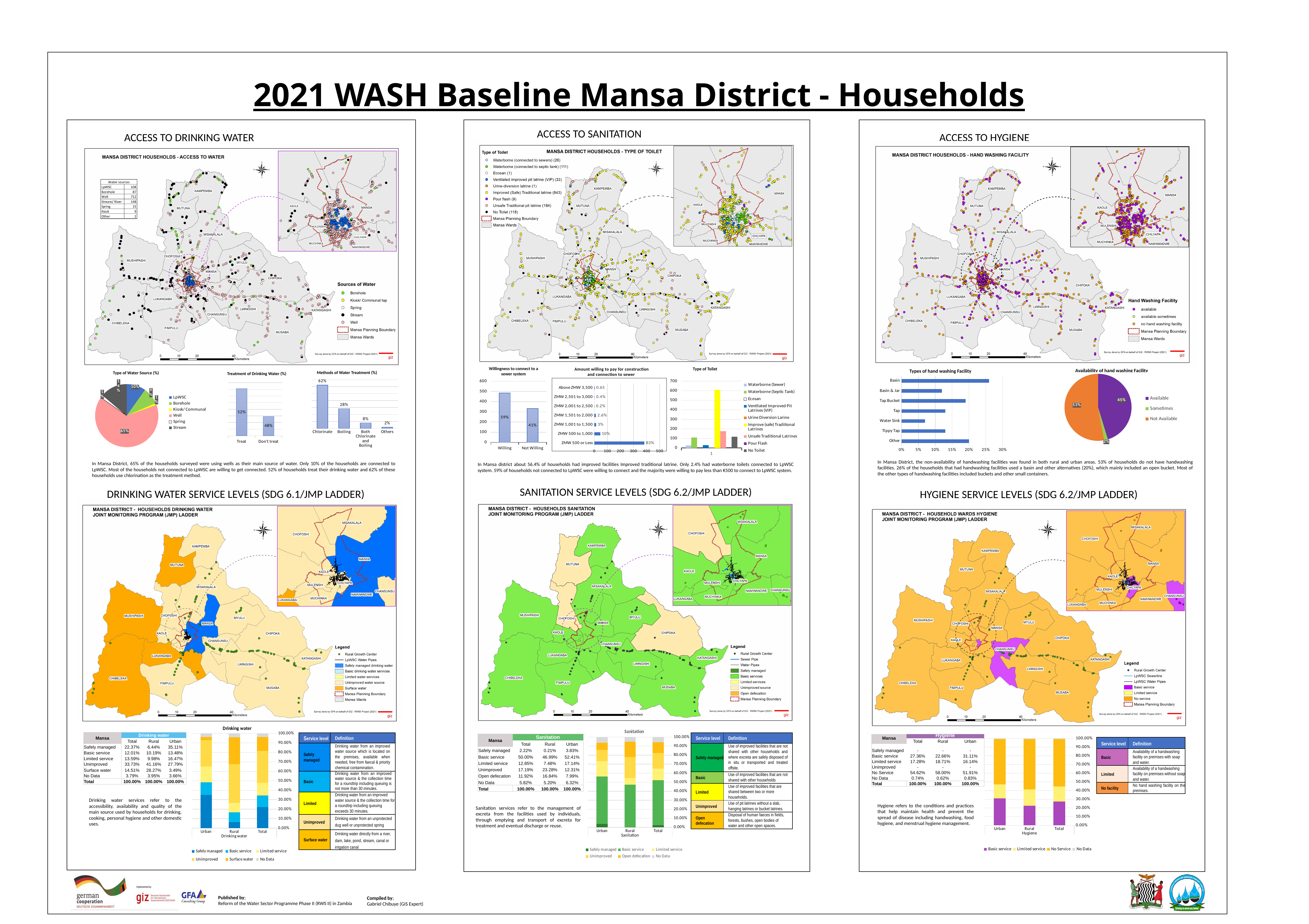
In the 'Type of Water Source (%)' pie chart, what share does Well have? 65% In the 'Willingness to connect to a sewer system' bar chart, what is the value for 'Not Willing'? 41% In the 'Hygiene' stacked bar chart, how many series does the legend list? 4 In the 'Drinking water' stacked bar chart, what is the 'Safely managed' value for Urban? 35.11% In the 'Treatment of Drinking Water (%)' bar chart, what is the value for 'Treat'? 52% In the 'Amount willing to pay for construction and connection to sewer' chart, which category has the lowest value? ZMW 2,001 to 2,500 In the 'Types of hand washing Facility' bar chart, which facility type has the highest value? Basin In the 'Type of Toilet' bar chart, is the value for 'Improve (safe) Traditional Latrines' greater or less than 500? greater In the 'Methods of Water Treatment (%)' bar chart, which method has the highest value? Chlorinate In the 'Methods of Water Treatment (%)' bar chart, what is the difference between Chlorinate and Boiling? 34% In the 'Availability of hand washing Facility' pie chart, what share is 'Not Available'? 53% In the 'Amount willing to pay for construction and connection to sewer' chart, what is the value for 'ZMW 500 or Less'? 83%